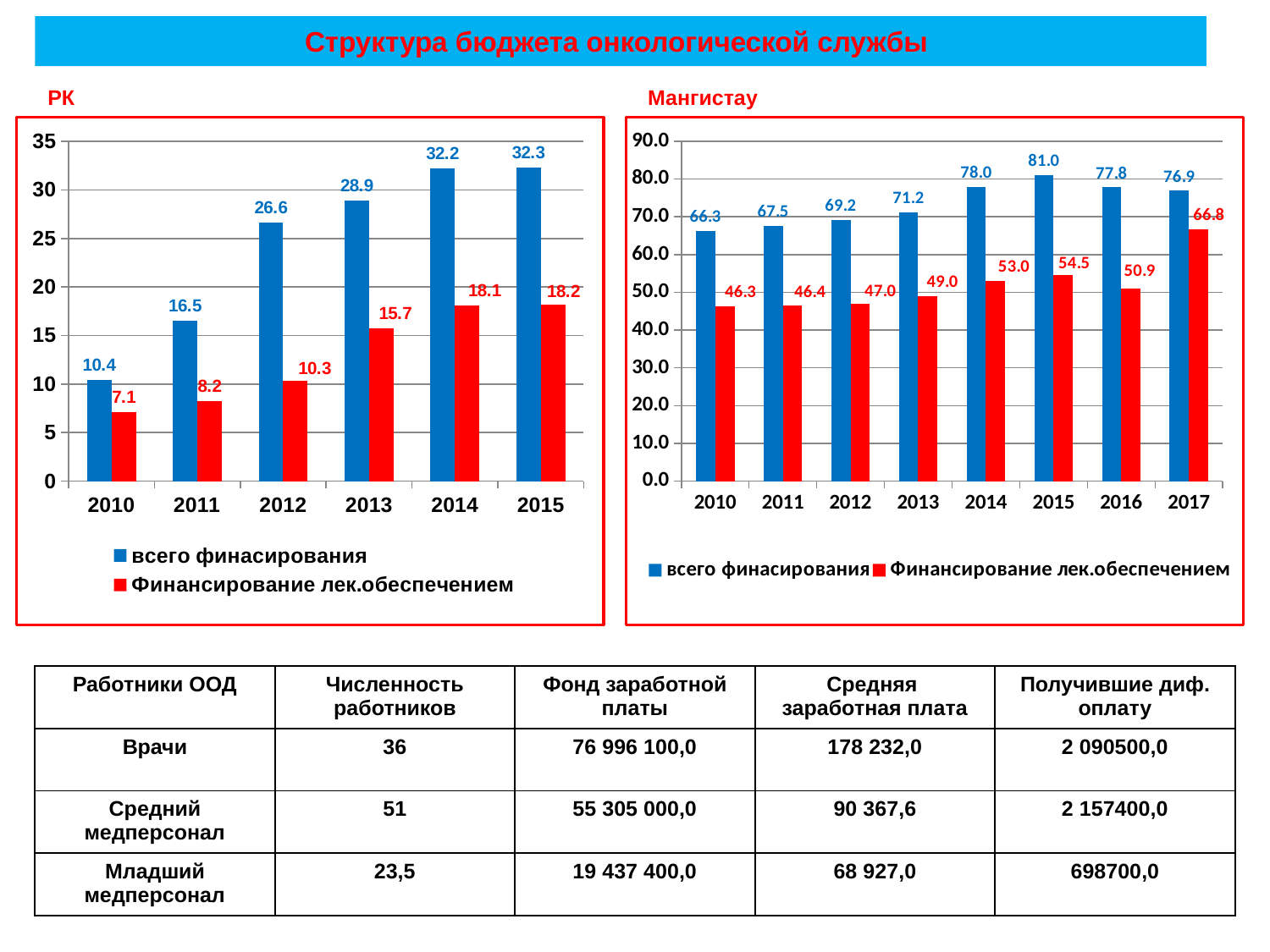
In the РК chart, what is the value of Финансирование лек.обеспечением for 2011? 8.2 In the Мангистау chart, what is the value of Финансирование лек.обеспечением for 2017? 66.8 In the РК chart, what is the value of всего финасирования for 2013? 28.9 In the Мангистау chart, which year has the highest value of всего финасирования? 2015 In the Мангистау chart, what is the difference between всего финасирования in 2014 and in 2010? 11.7 In the Мангистау chart, which is larger: Финансирование лек.обеспечением in 2016 or in 2017? 2017 In the РК chart, what is the difference between всего финасирования and Финансирование лек.обеспечением in 2014? 14.1 How many series does the legend of the РК chart list? 2 What type of chart is the РК chart? bar chart In the РК chart, which year has the lowest value of Финансирование лек.обеспечением? 2010 How many years are shown on the x axis of the Мангистау chart? 8 In the Мангистау chart, what is the value of всего финасирования for 2015? 81.0